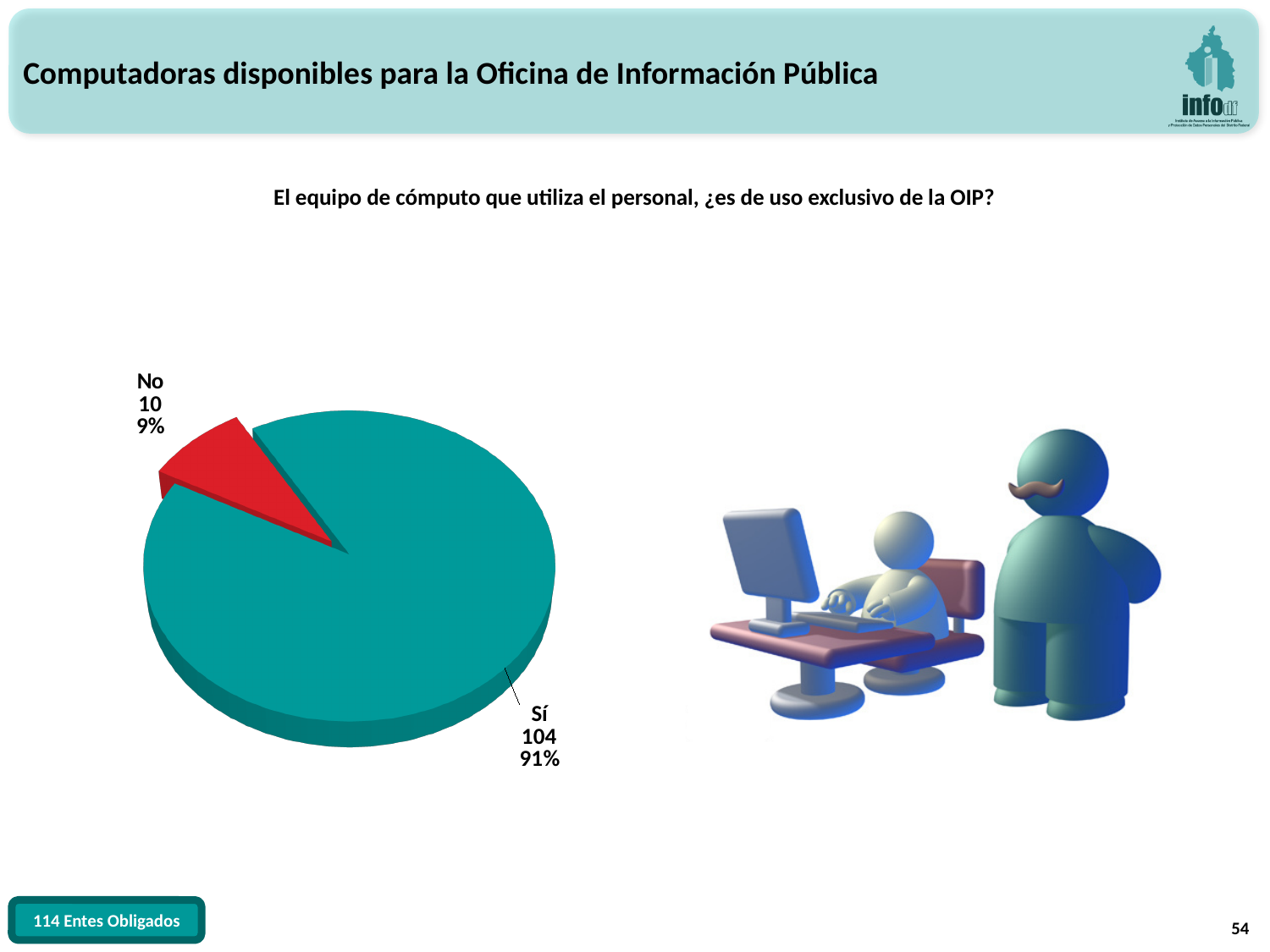
What is the count for the "Sí" slice? 104 What share of the pie does the "No" slice represent? 9% What is the total of the two slice counts? 114 What is the count for the "No" slice? 10 How many slices does the pie chart have? 2 Which is larger, the "Sí" slice or the "No" slice? Sí Which slice is the smallest? No What kind of chart is shown on the slide? pie chart What share of the pie does the "Sí" slice represent? 91% What colour is the "No" slice? red Which slice is the largest? Sí What is the difference between the counts for "Sí" and "No"? 94